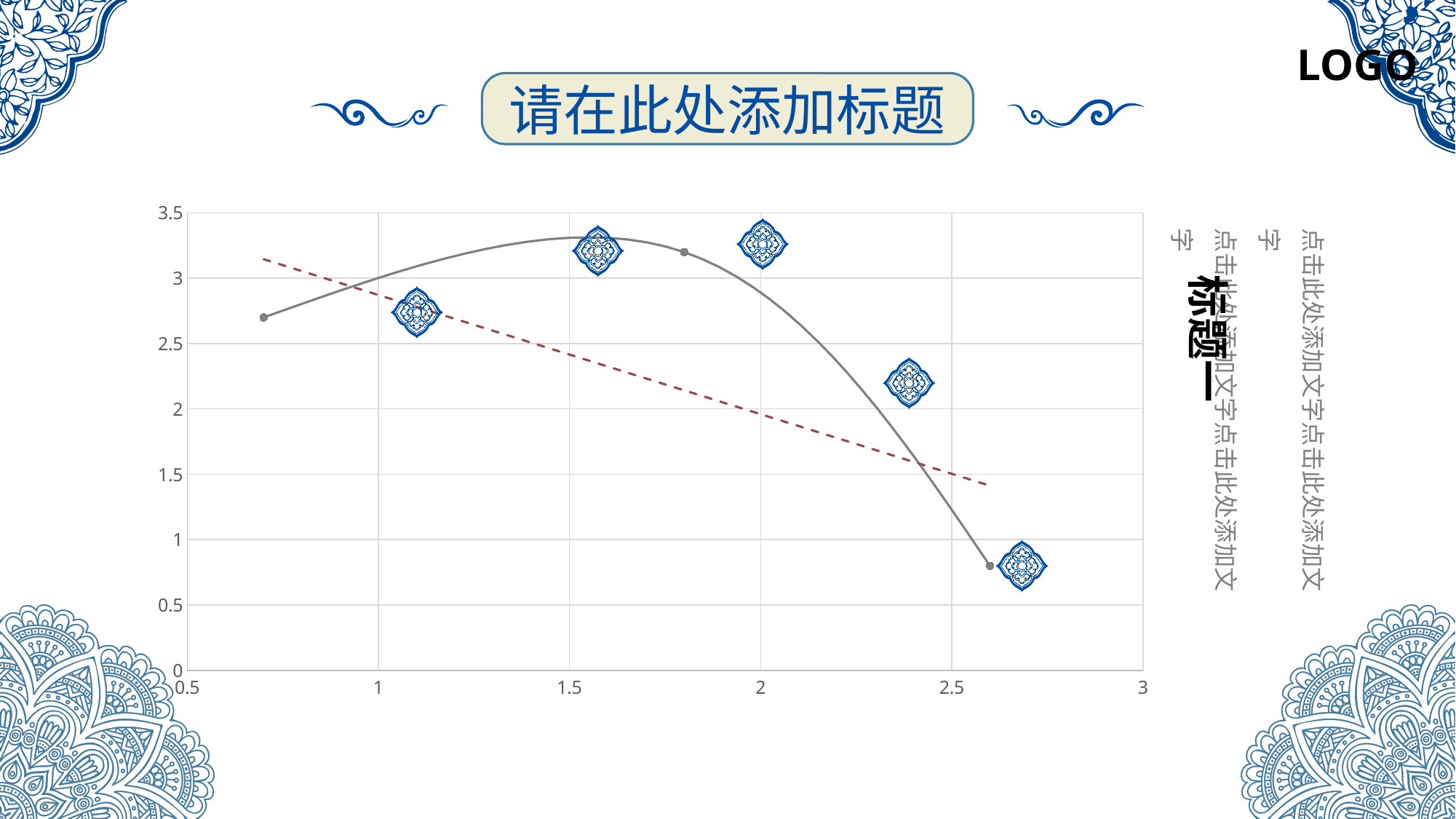
Is the value of the lowest point on the curve (near x = 2.6) greater or less than 1? less What range does the horizontal axis cover? 0.5 to 3 Does the dashed trend line rise or fall from left to right? falls Which point has the lowest value on the curve: the one near x = 2.6 or the one near x = 0.7? the one near x = 2.6 What is the highest value shown on the vertical axis? 3.5 What kind of chart is shown on the slide? scatter chart with a smoothed line Is the value of the first point on the curve (near x = 0.7) greater or less than 2.5? greater How does the solid curve behave after x = 2 as x increases? it falls